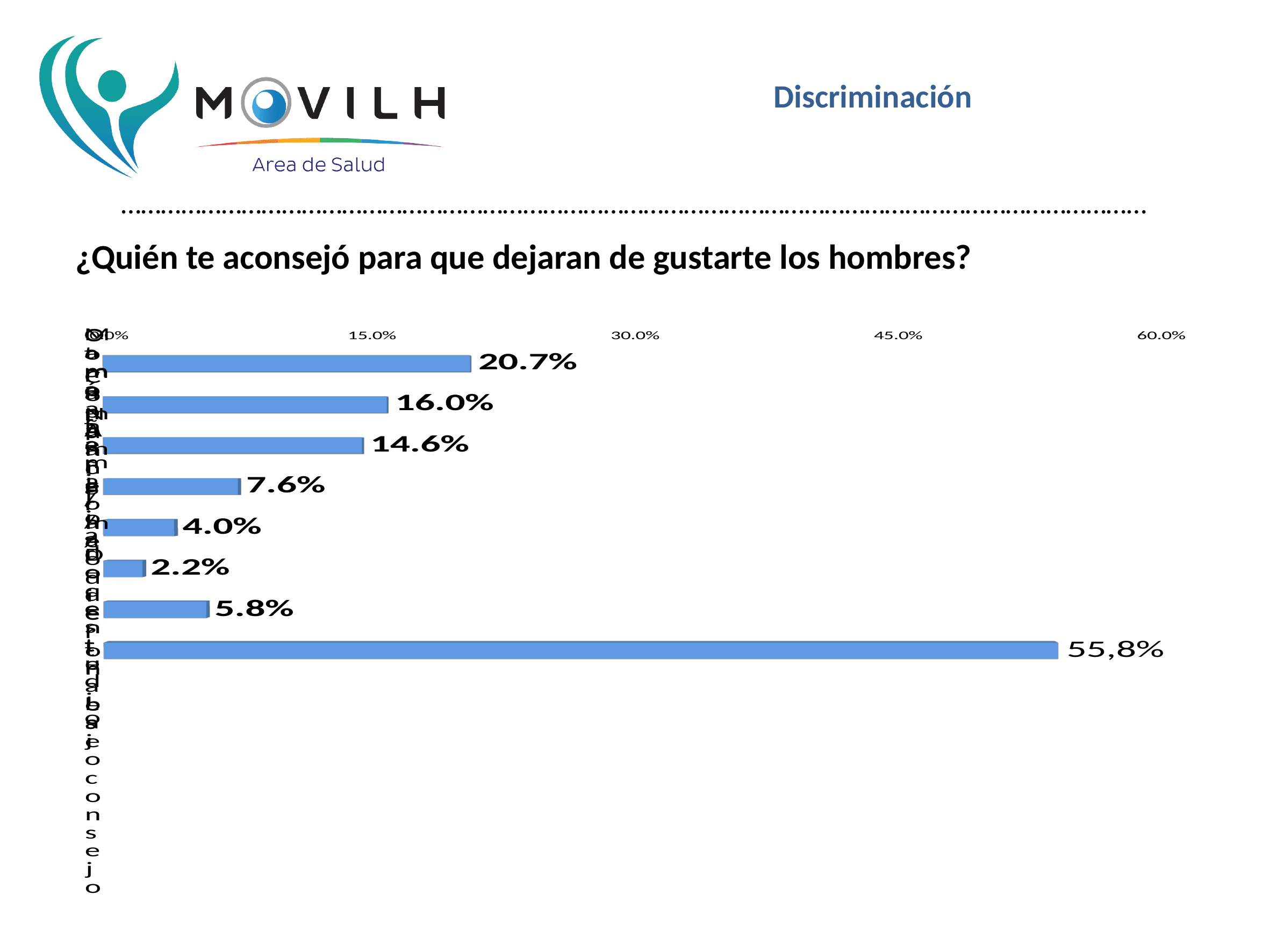
What is the difference between the values of the topmost bar (20.7%) and the second bar from the top (16.0%)? 4.7% What is the highest value shown on any bar in the chart? 55,8% What is the value shown on the third bar from the top? 14.6% What is the value shown on the topmost bar of the chart? 20.7% What is the value shown on the second bar from the top? 16.0% What is the value shown on the bottom bar of the chart? 55,8% What kind of chart is shown on the slide? bar chart How many bars does the chart contain? 8 What question is used as the title of the chart? ¿Quién te aconsejó para que dejaran de gustarte los hombres? Which is larger: the fourth bar from the top (7.6%) or the seventh bar from the top (5.8%)? the fourth bar from the top (7.6%) Is the value of the bottom bar greater or less than 45.0%? greater What is the lowest value shown on any bar in the chart? 2.2%